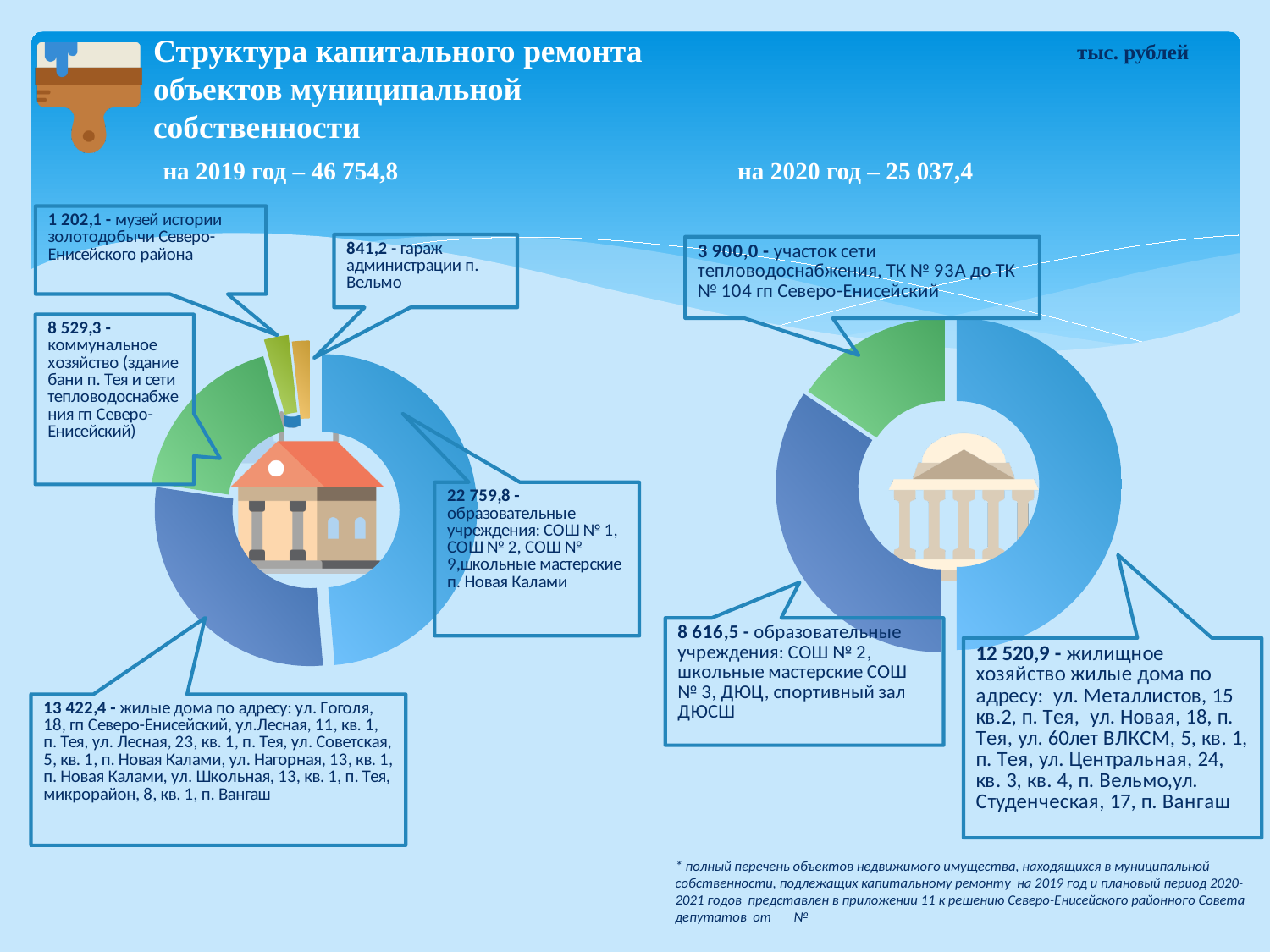
What kind of chart is used for the 2020 data? doughnut chart On the 2019 chart (на 2019 год), what is the value for образовательные учреждения? 22 759,8 On the 2019 chart, what is the difference between образовательные учреждения and жилые дома? 9 337,4 On the 2019 chart, which is larger: коммунальное хозяйство or музей истории золотодобычи? коммунальное хозяйство On the 2020 chart, which category has the smallest value? участок сети тепловодоснабжения On the 2019 chart, which category has the largest value? образовательные учреждения How many categories does the 2020 chart show? 3 How many categories does the 2019 chart show? 5 On the 2020 chart, what is the difference between жилищное хозяйство and образовательные учреждения? 3 904,4 On the 2020 chart (на 2020 год), what is the value for жилищное хозяйство? 12 520,9 On the 2019 chart, what is the value for гараж администрации п. Вельмо? 841,2 On the 2019 chart, which category has the smallest value? гараж администрации п. Вельмо